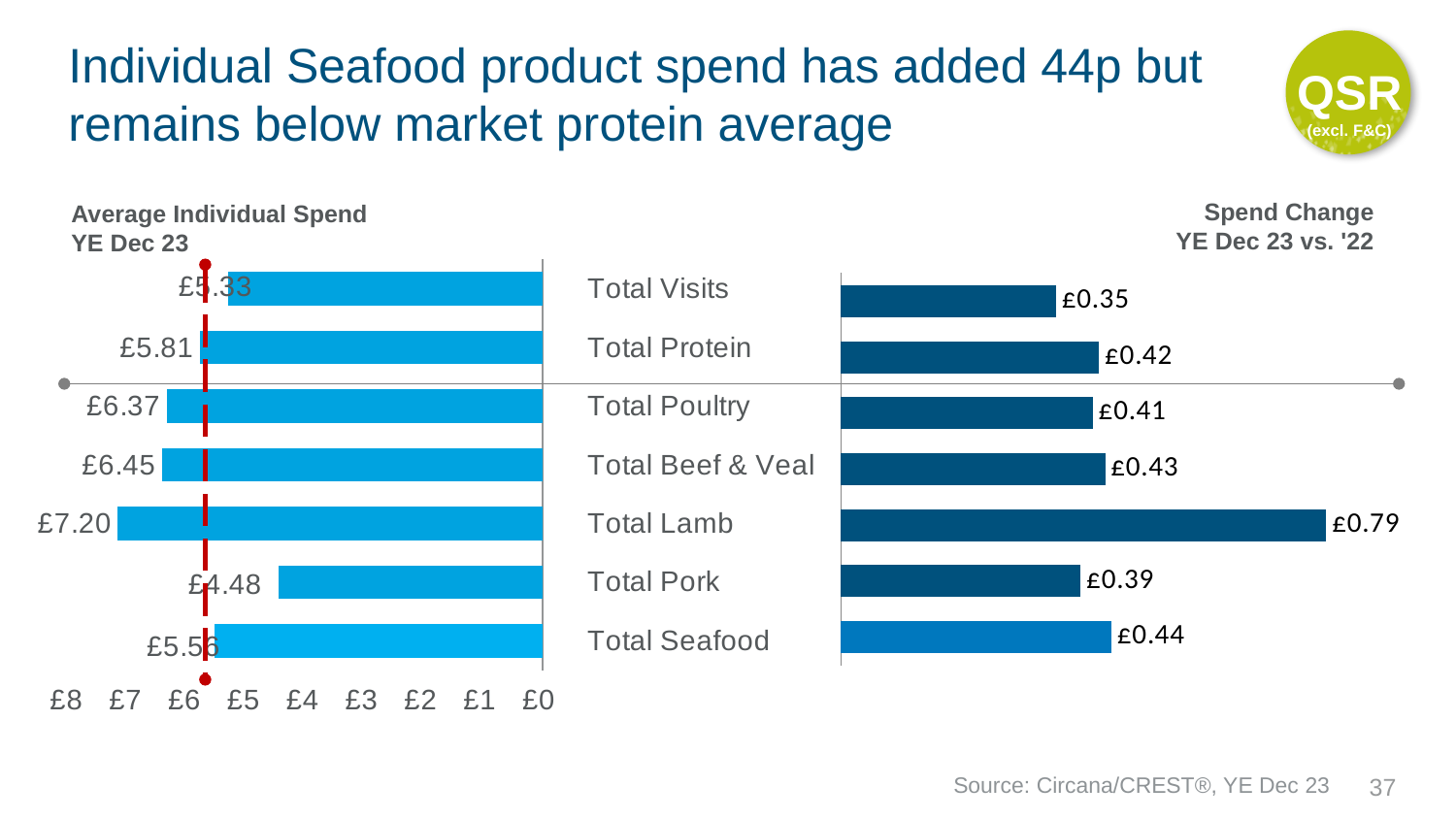
In the Average Individual Spend YE Dec 23 chart, what is the difference between Total Protein and Total Seafood? £0.25 What kind of chart is the Spend Change YE Dec 23 vs. '22 chart? Bar chart In the Average Individual Spend YE Dec 23 chart, which category has the highest value? Total Lamb In the Spend Change YE Dec 23 vs. '22 chart, what is the value for Total Visits? £0.35 In the Spend Change YE Dec 23 vs. '22 chart, what is the value for Total Seafood? £0.44 In the Spend Change YE Dec 23 vs. '22 chart, which is larger, Total Poultry or Total Beef & Veal? Total Beef & Veal In the Spend Change YE Dec 23 vs. '22 chart, which category has the lowest value? Total Visits In the Average Individual Spend YE Dec 23 chart, which category has the lowest value? Total Pork In the Spend Change YE Dec 23 vs. '22 chart, which category has the highest value? Total Lamb In the Average Individual Spend YE Dec 23 chart, what is the value for Total Lamb? £7.20 How many categories are shown in the Average Individual Spend YE Dec 23 chart? 7 In the Average Individual Spend YE Dec 23 chart, what is the value for Total Seafood? £5.56